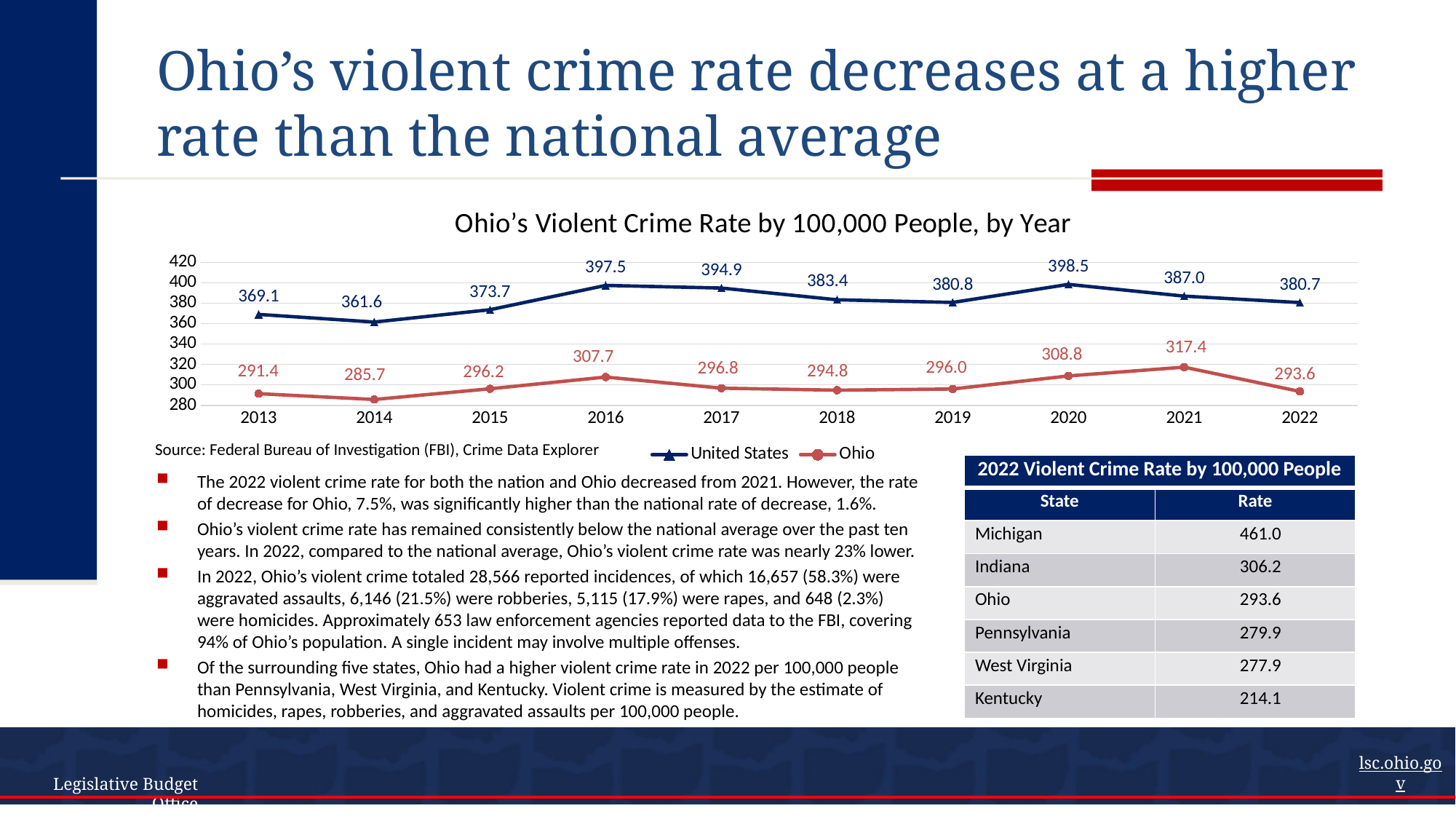
What was the United States violent crime rate in 2020? 398.5 How many years are plotted on the x axis of the chart? 10 Did Ohio's violent crime rate rise or fall from 2021 to 2022? Fall What kind of chart is shown on the slide? Line chart In which year was Ohio's violent crime rate highest? 2021 In which year was the United States violent crime rate lowest? 2014 Which had a higher violent crime rate in 2021, the United States or Ohio? United States What is the title of the chart? Ohio's Violent Crime Rate by 100,000 People, by Year What is the difference between the United States and Ohio violent crime rates in 2022? 87.1 By how much did Ohio's violent crime rate change from 2013 to 2014? 5.7 What was Ohio's violent crime rate in 2016? 307.7 How many series does the chart's legend list? 2